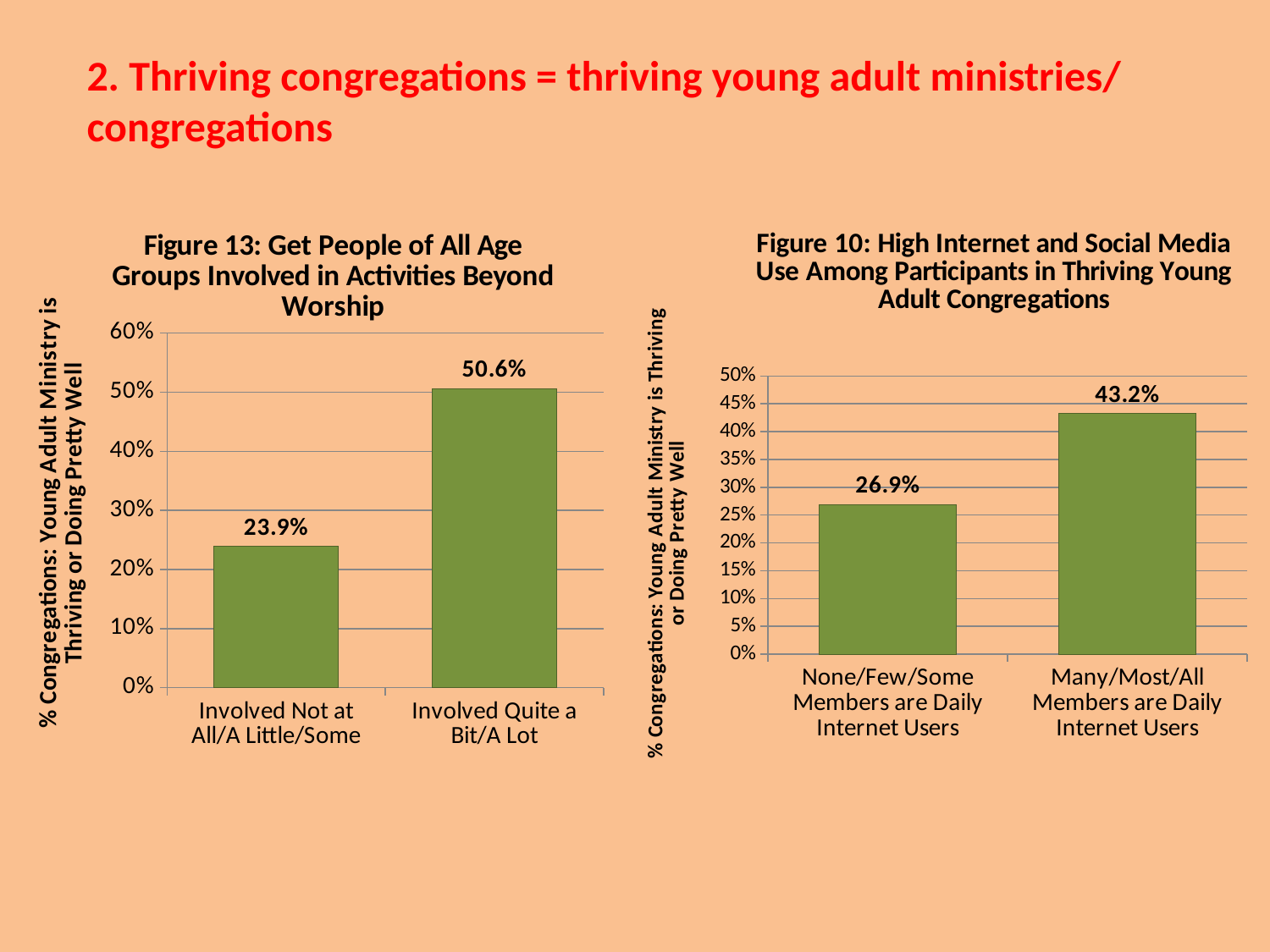
In the Figure 13 chart on the left, what is the value for 'Involved Not at All/A Little/Some'? 23.9% In the Figure 13 chart on the left, which category has the highest value? Involved Quite a Bit/A Lot In the Figure 10 chart on the right, what is the value for 'None/Few/Some Members are Daily Internet Users'? 26.9% In the Figure 10 chart on the right, is the value for 'None/Few/Some Members are Daily Internet Users' greater or less than 30%? less In the Figure 13 chart on the left, what is the difference between the two bars? 26.7% How many bars are in the Figure 13 chart on the left? 2 In the Figure 10 chart on the right, what is the value for 'Many/Most/All Members are Daily Internet Users'? 43.2% What is the y-axis label of the Figure 13 chart on the left? % Congregations: Young Adult Ministry is Thriving or Doing Pretty Well What kind of chart is the Figure 10 chart on the right? bar chart In the Figure 13 chart on the left, what is the value for 'Involved Quite a Bit/A Lot'? 50.6% In the Figure 10 chart on the right, what is the difference between the two bars? 16.3% In the Figure 10 chart on the right, which category has the lowest value? None/Few/Some Members are Daily Internet Users